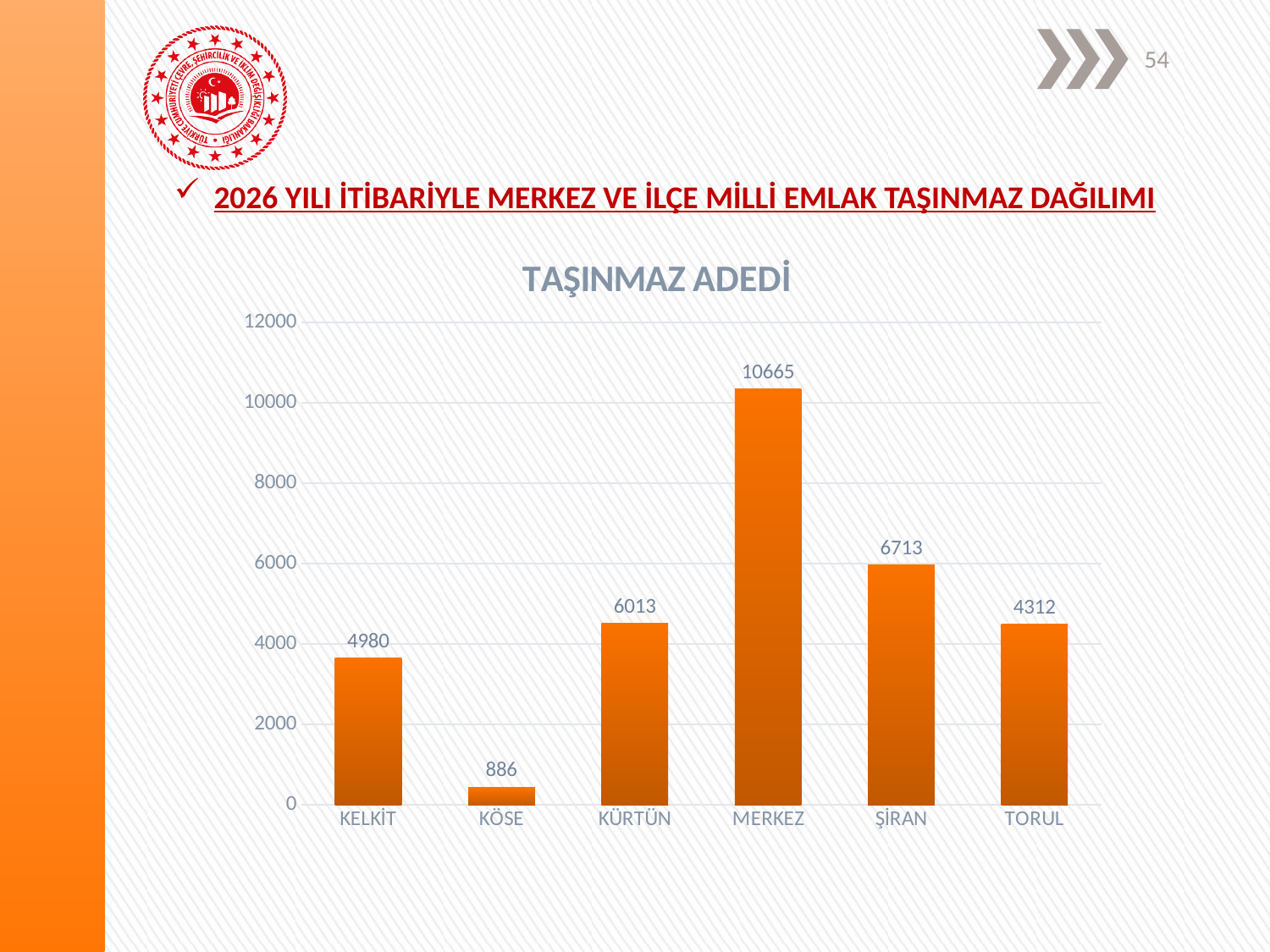
Which is larger, the value for ŞİRAN or the value for KÜRTÜN? ŞİRAN What kind of chart is shown on the slide? bar chart What is the title of the chart on the slide? TAŞINMAZ ADEDİ What is the value for MERKEZ in the TAŞINMAZ ADEDİ chart? 10665 What is the difference between the values for KÜRTÜN and KELKİT? 1033 How many categories are shown on the x axis of the TAŞINMAZ ADEDİ chart? 6 What is the value for TORUL in the TAŞINMAZ ADEDİ chart? 4312 Which category has the lowest value in the TAŞINMAZ ADEDİ chart? KÖSE Which category has the highest value in the TAŞINMAZ ADEDİ chart? MERKEZ What is the value for KÖSE in the TAŞINMAZ ADEDİ chart? 886 What is the difference between the values for MERKEZ and ŞİRAN? 3952